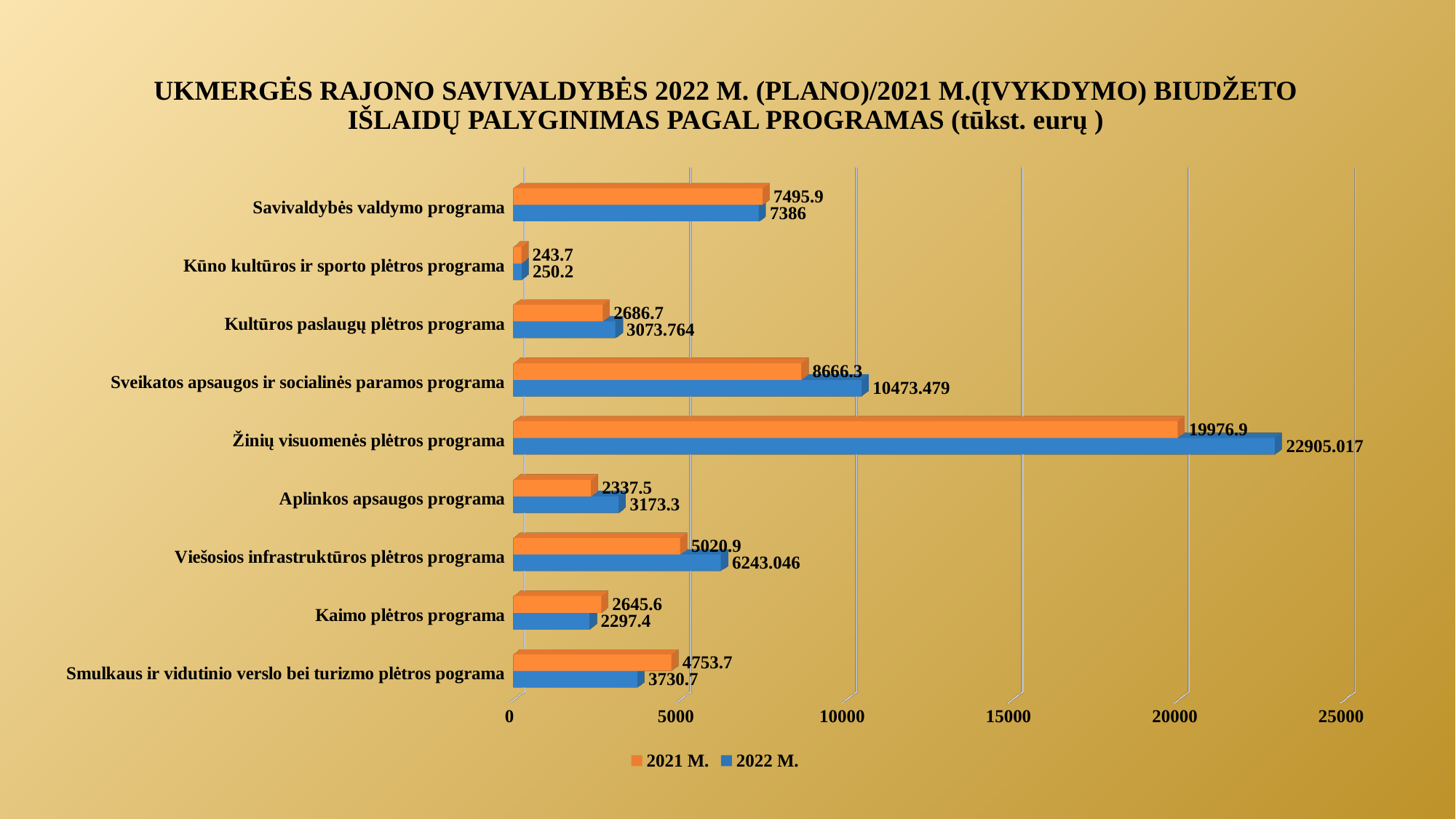
What is the difference between the 2021 M. and 2022 M. values for Smulkaus ir vidutinio verslo bei turizmo plėtros pograma? 1023 How many series does the legend list? 2 How many programmes are shown on the chart? 9 Which programme has the highest 2021 M. value? Žinių visuomenės plėtros programa What is the difference between the 2021 M. and 2022 M. values for Kaimo plėtros programa? 348.2 Is the 2022 M. value for Sveikatos apsaugos ir socialinės paramos programa greater or less than 10000? greater What kind of chart is shown on the slide? Bar chart What is the 2022 M. value for Žinių visuomenės plėtros programa? 22905.017 What is the 2021 M. value for Sveikatos apsaugos ir socialinės paramos programa? 8666.3 Which programme has the lowest 2022 M. value? Kūno kultūros ir sporto plėtros programa For Aplinkos apsaugos programa, which is larger: the 2021 M. value or the 2022 M. value? 2022 M. What is the 2022 M. value for Viešosios infrastruktūros plėtros programa? 6243.046